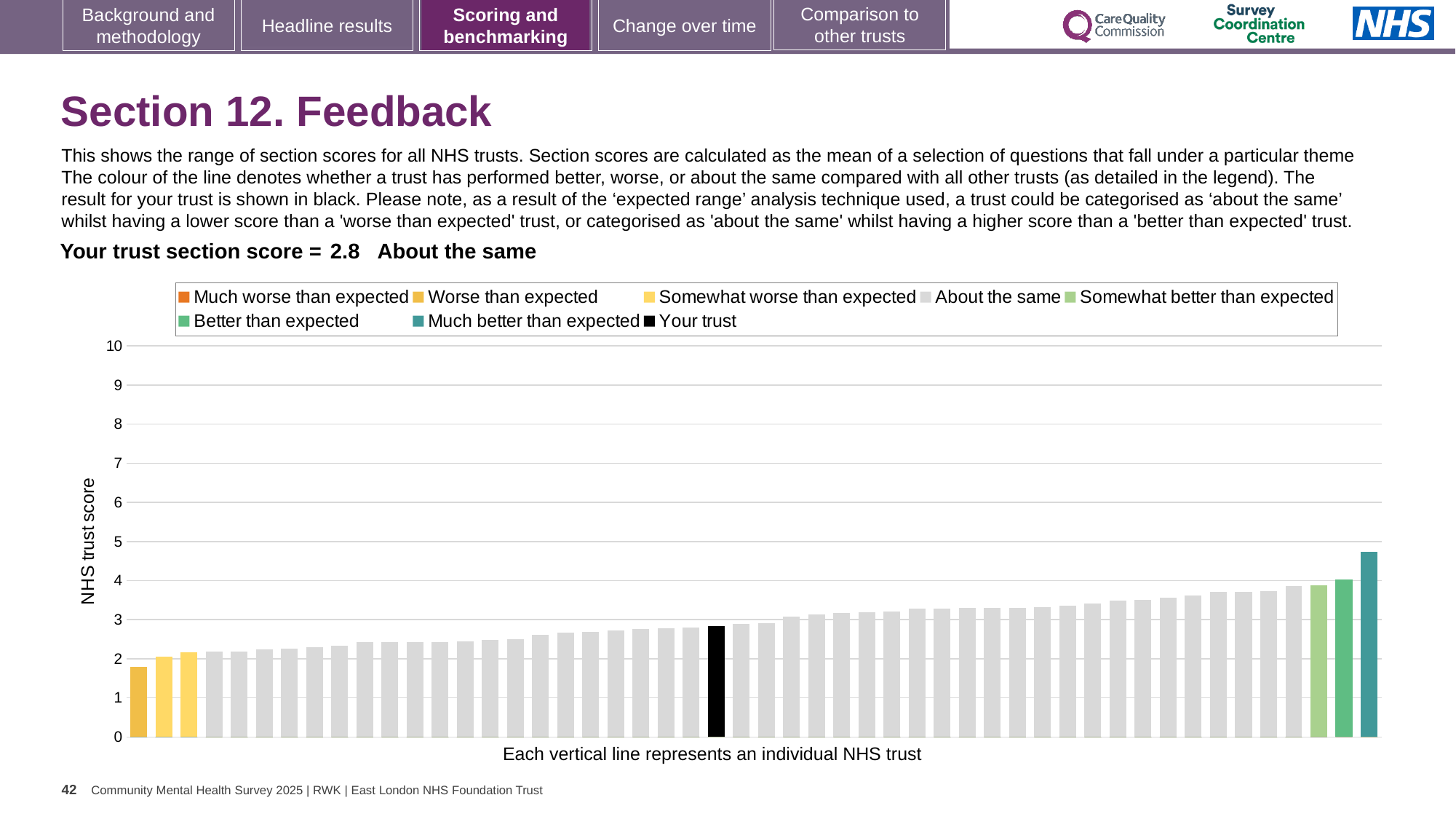
Which legend category does the shortest bar belong to? Worse than expected Which category is your trust's section score placed in? About the same Do the bar values rise or fall from left to right along the x axis? Rise What kind of chart is shown on the slide? Bar chart Is the value of the shortest bar greater or less than 2? less Is the value for your trust greater or less than 3? less How many bars are coloured as 'Somewhat worse than expected'? 2 Is the value of the tallest bar greater or less than 4? greater What is the label on the vertical axis of the chart? NHS trust score How many entries does the chart legend list? 8 What is the section score for your trust? 2.8 Which legend category does the tallest bar belong to? Much better than expected